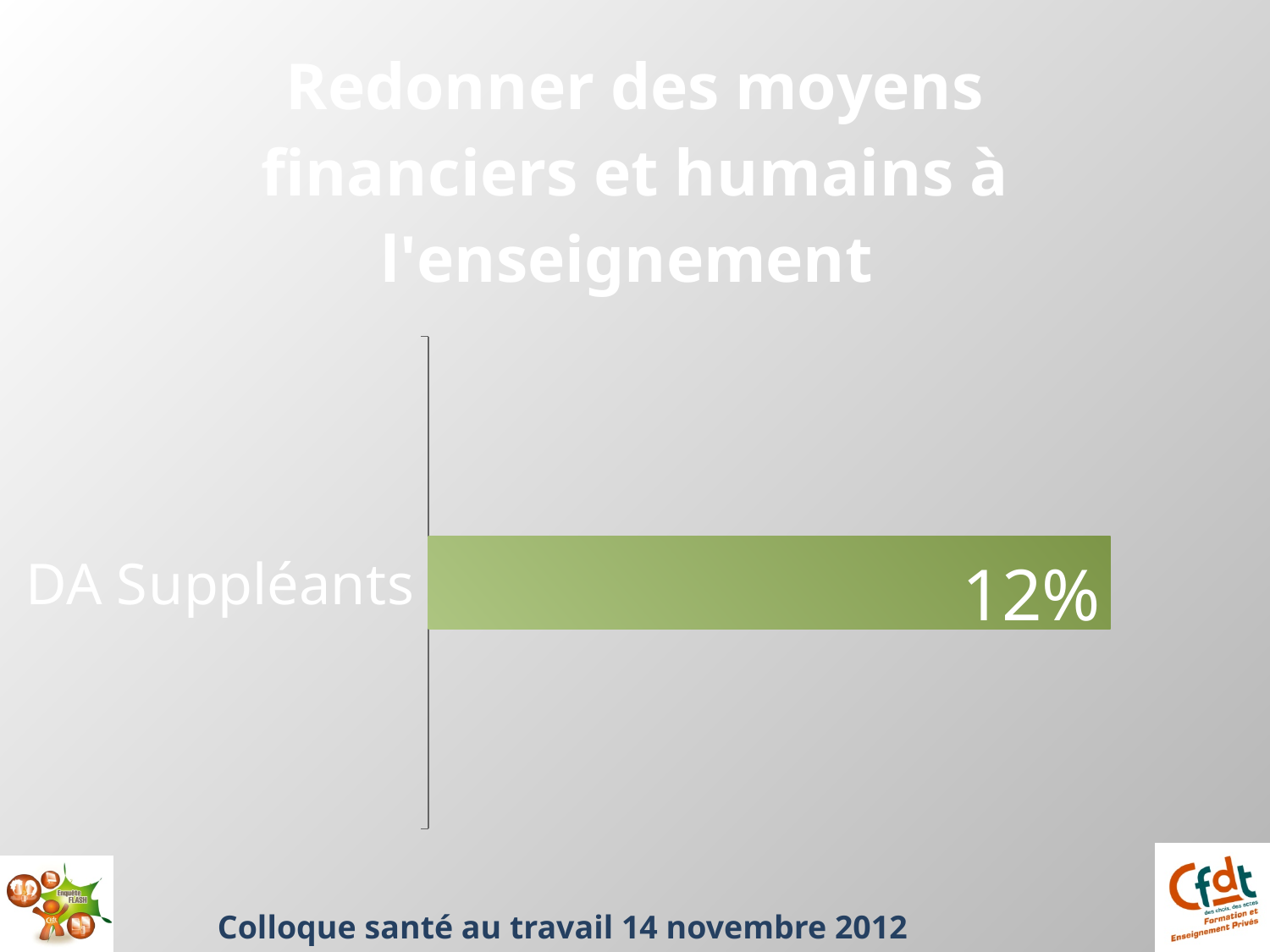
What is the title of the chart? Redonner des moyens financiers et humains à l'enseignement What is the value for DA Suppléants? 12% What kind of chart is shown on the slide? bar chart How many categories does the chart show? 1 What colour is the bar for DA Suppléants? green Which category is shown on the chart? DA Suppléants